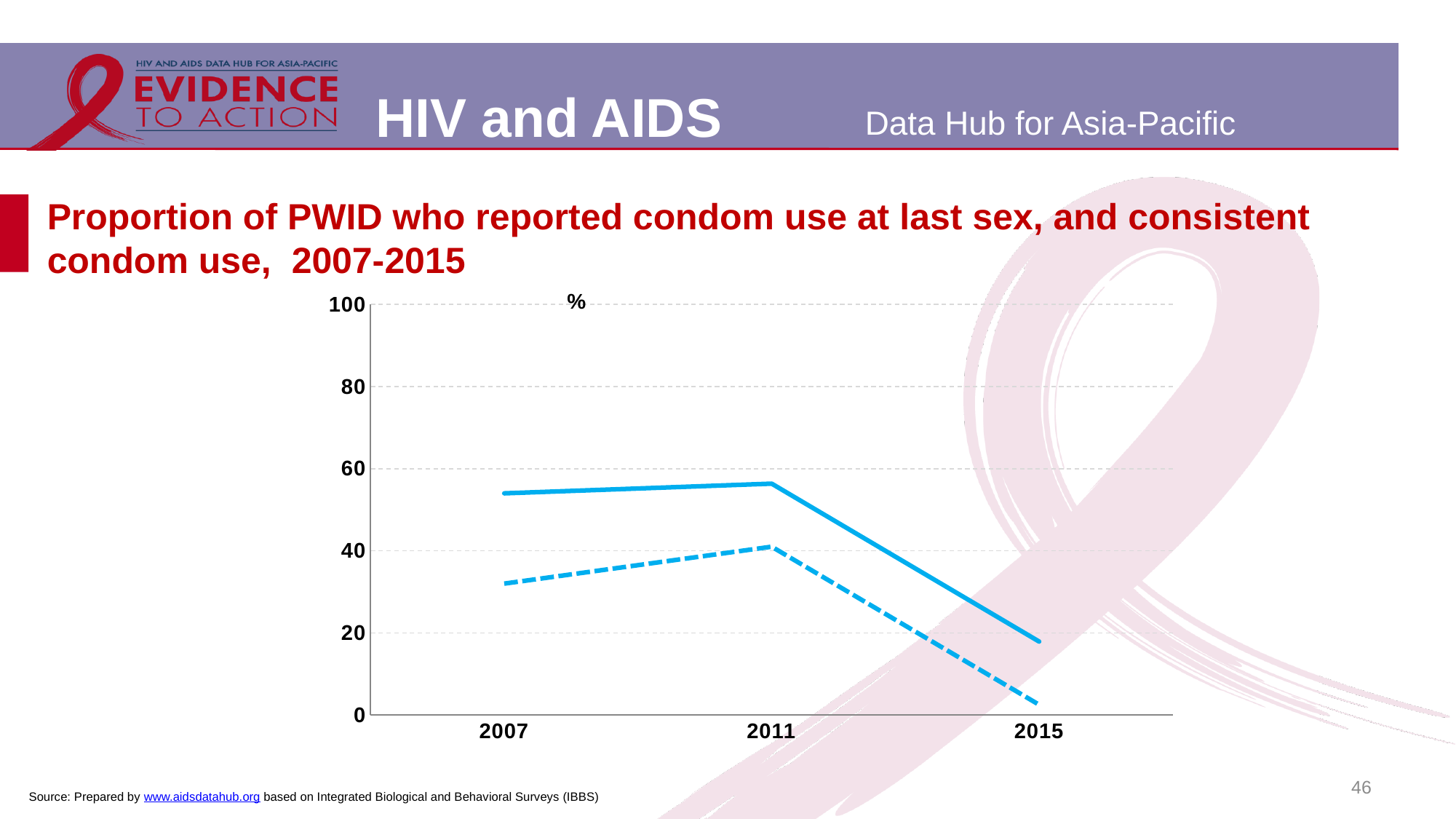
What kind of chart is shown on the slide? line chart What unit is shown at the top of the y axis of the chart? % Is the value of the dashed line in 2007 greater or less than 20? greater Is the value of the solid line in 2015 greater or less than 20? less Is the value of the solid line in 2007 greater or less than 40? greater In which year does the dashed line reach its highest value? 2011 In which year does the solid line reach its lowest value? 2015 Do the values of the solid line rise or fall between 2011 and 2015? fall In 2011, which line has the higher value, the solid line or the dashed line? the solid line How many years are shown on the x axis of the chart? 3